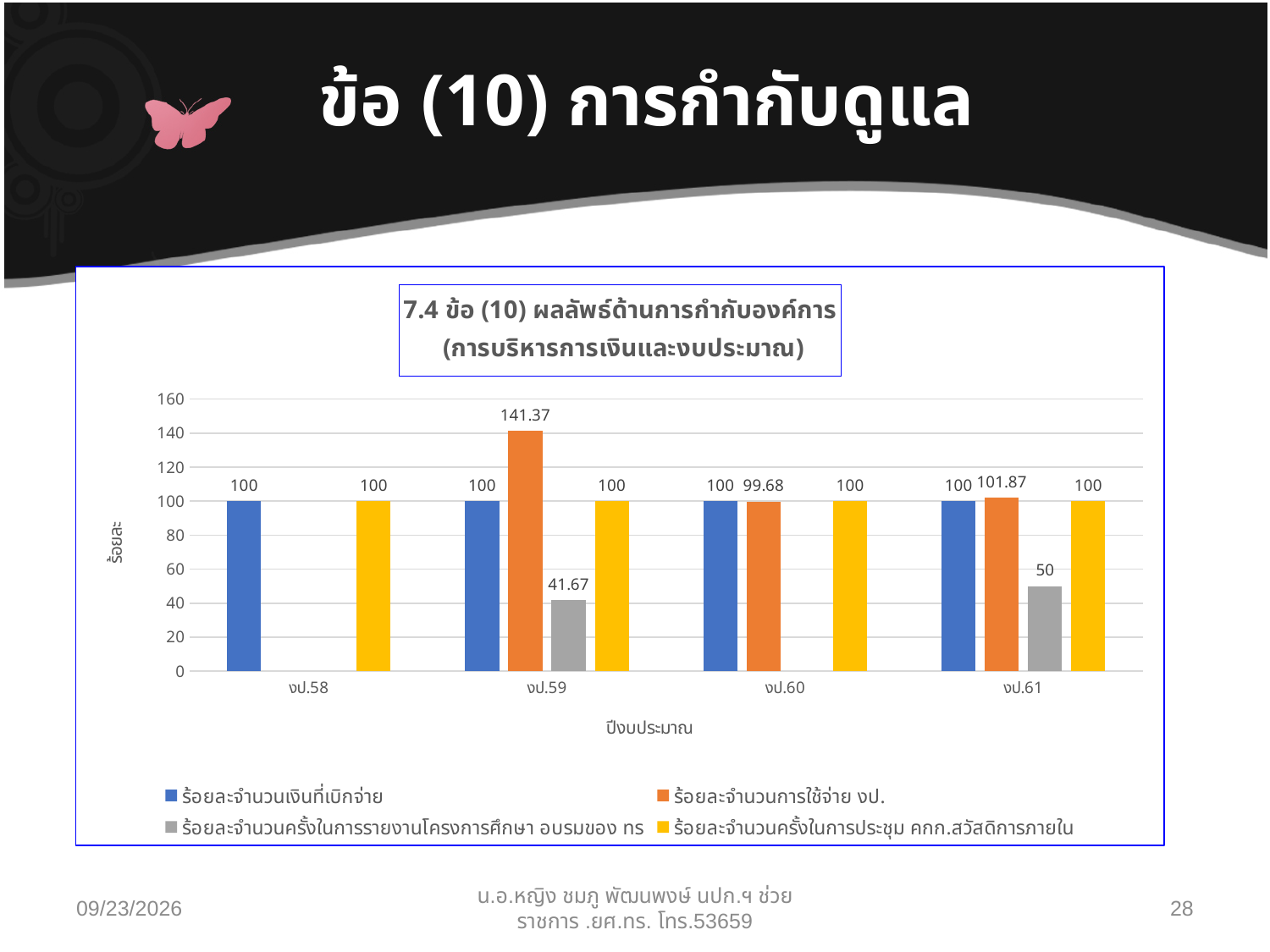
What is the label of the y axis? ร้อยละ What is the value of ร้อยละจำนวนการใช้จ่าย งป. for งป.59? 141.37 Is the value of ร้อยละจำนวนการใช้จ่าย งป. for งป.59 greater or less than 120? greater What is the difference between ร้อยละจำนวนการใช้จ่าย งป. for งป.59 and for งป.61? 39.5 What is the value of ร้อยละจำนวนครั้งในการรายงานโครงการศึกษา อบรมของ ทร for งป.61? 50 What is the value of ร้อยละจำนวนการใช้จ่าย งป. for งป.60? 99.68 What type of chart is shown on the slide? bar chart How many fiscal-year categories are shown on the x axis? 4 Which is larger: ร้อยละจำนวนครั้งในการรายงานโครงการศึกษา อบรมของ ทร for งป.59 or for งป.61? งป.61 In which fiscal year is ร้อยละจำนวนการใช้จ่าย งป. lowest? งป.60 How many series does the legend list? 4 In which fiscal year is ร้อยละจำนวนการใช้จ่าย งป. highest? งป.59